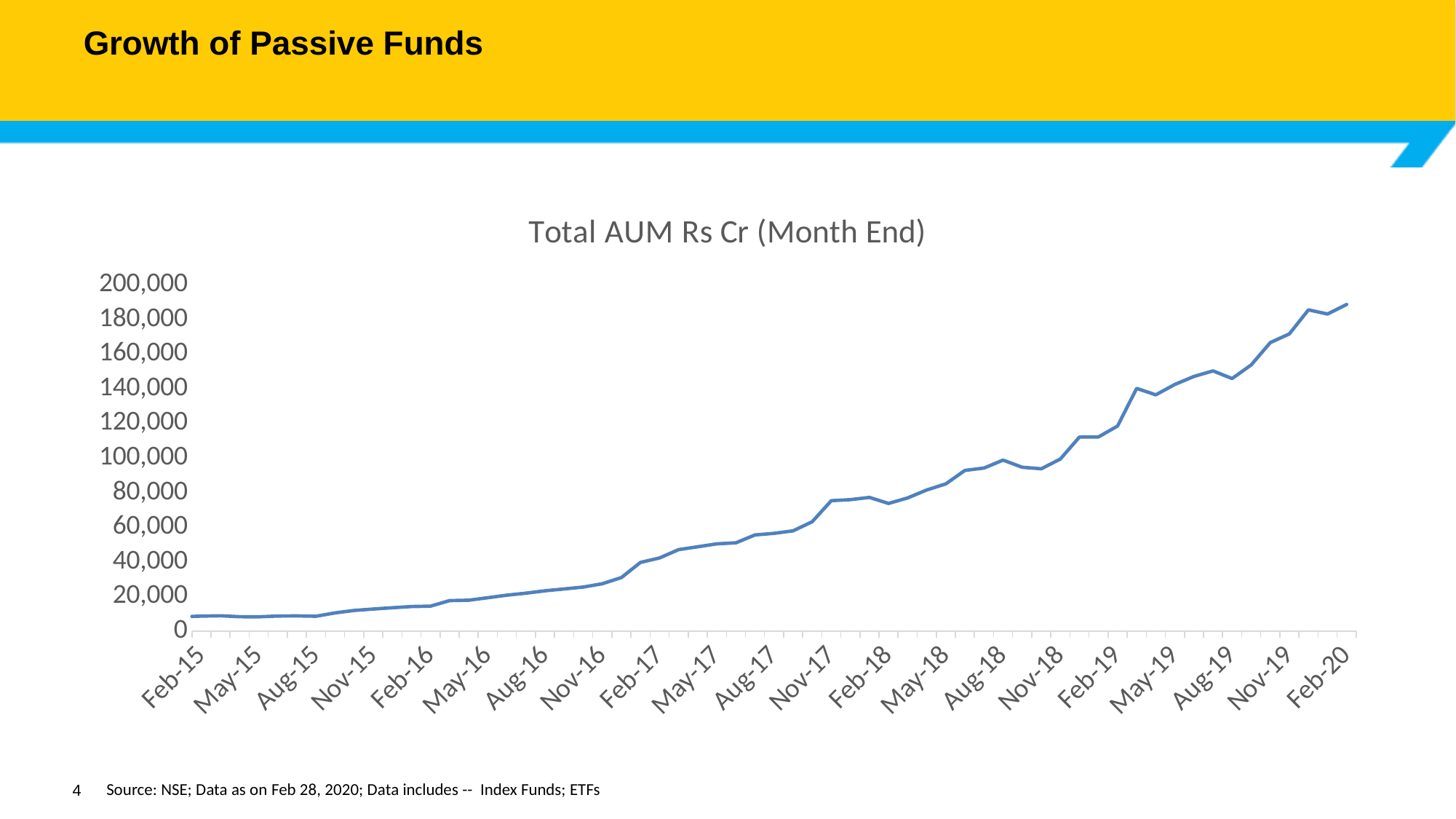
Which is larger, the value for Feb-20 or the value for Feb-15? Feb-20 What is the highest value shown on the y axis? 200,000 Do the values generally rise or fall from Feb-15 to Feb-20? Rise Is the value for Feb-17 greater or less than 60,000? less Is the value for Nov-17 greater or less than 60,000? greater How many month labels are shown on the x axis? 21 What is the title of the chart? Total AUM Rs Cr (Month End) Is the value for Feb-19 greater or less than 100,000? greater Which labelled month on the x axis has the highest value? Feb-20 What kind of chart is shown on the slide? Line chart